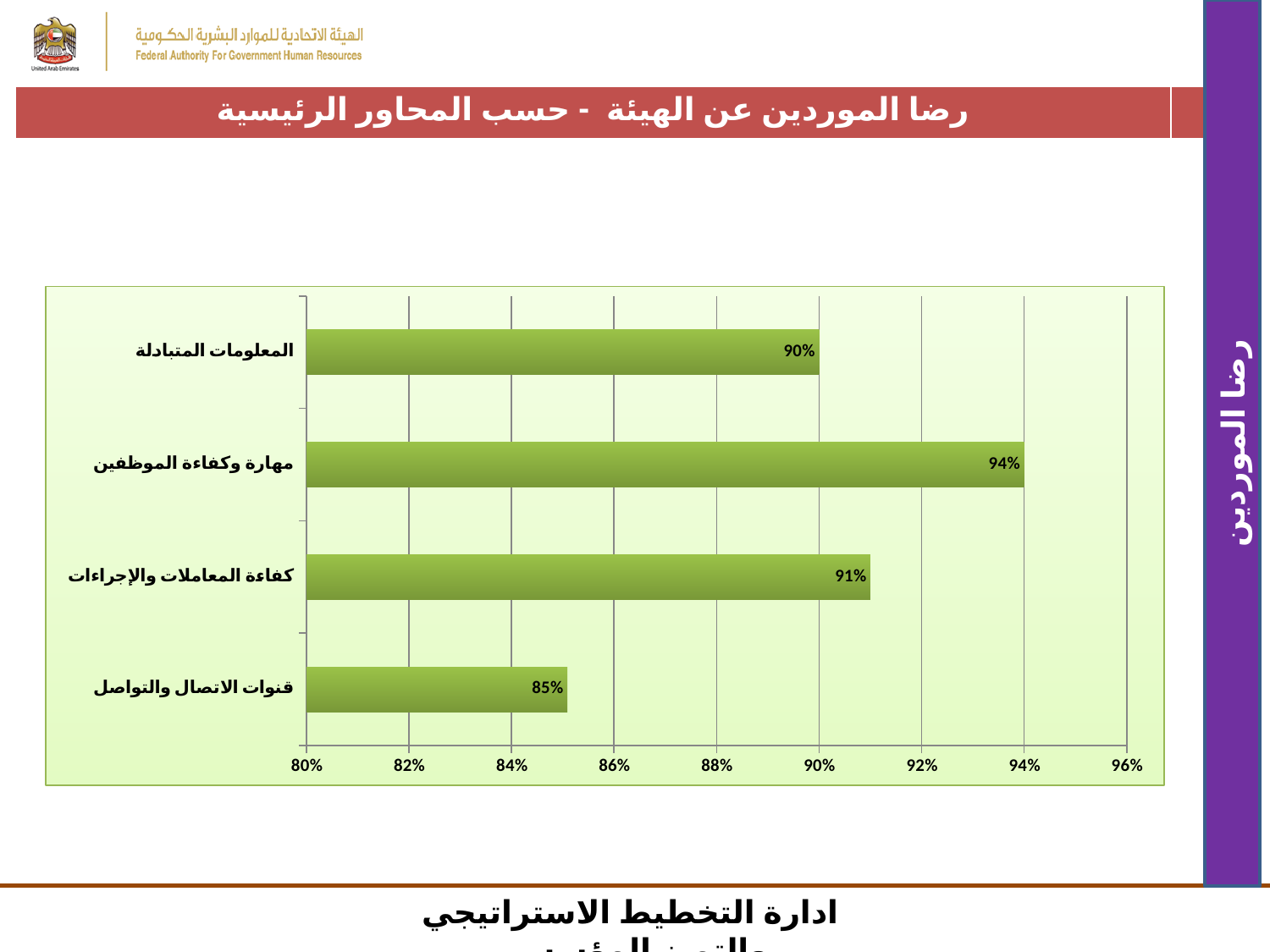
How many categories are shown in the chart? 4 What is the value for قنوات الاتصال والتواصل? 85% What is the difference between the values for كفاءة المعاملات والإجراءات and المعلومات المتبادلة? 1% Which is larger, the value for المعلومات المتبادلة or the value for قنوات الاتصال والتواصل? المعلومات المتبادلة What is the difference between the values for مهارة وكفاءة الموظفين and قنوات الاتصال والتواصل? 9% What is the value for المعلومات المتبادلة? 90% Which category has the highest value? مهارة وكفاءة الموظفين Which category has the lowest value? قنوات الاتصال والتواصل Is the value for كفاءة المعاملات والإجراءات greater or less than 90%? greater What kind of chart is shown on the slide? bar chart What is the value for كفاءة المعاملات والإجراءات? 91% What is the value for مهارة وكفاءة الموظفين? 94%